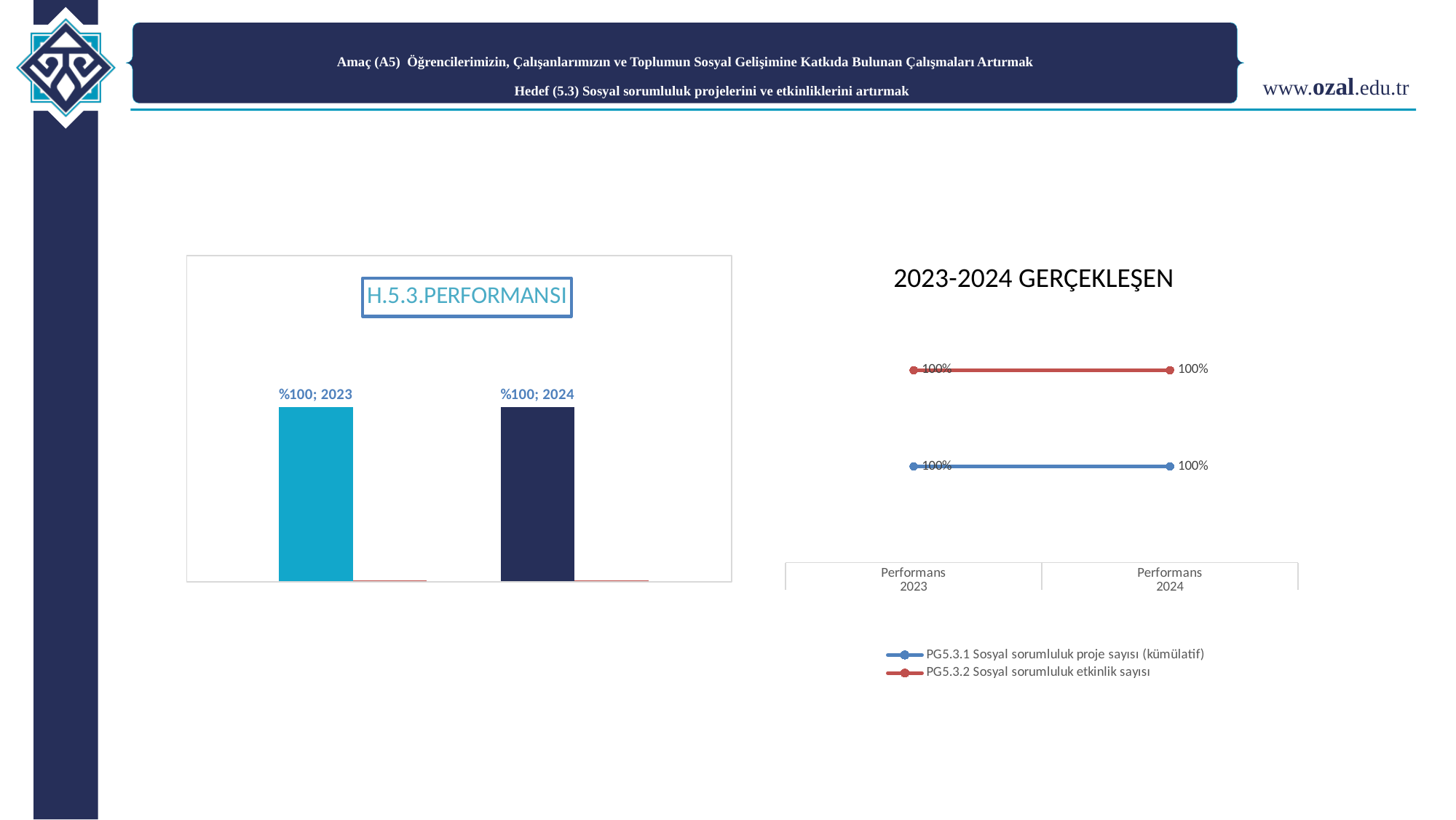
In the 2023-2024 GERÇEKLEŞEN chart, which colour is the line for PG5.3.2 Sosyal sorumluluk etkinlik sayısı? red In the H.5.3.PERFORMANSI chart, what is the value for 2024? %100 What kind of chart is the H.5.3.PERFORMANSI chart? bar chart How many series does the legend of the 2023-2024 GERÇEKLEŞEN chart list? 2 In the 2023-2024 GERÇEKLEŞEN chart, how many categories are on the x axis? 2 In the H.5.3.PERFORMANSI chart, what is the difference between the 2023 and 2024 values? 0 In the 2023-2024 GERÇEKLEŞEN chart, what is the value of PG5.3.2 Sosyal sorumluluk etkinlik sayısı for Performans 2024? 100% In the 2023-2024 GERÇEKLEŞEN chart, what is the value of PG5.3.1 Sosyal sorumluluk proje sayısı (kümülatif) for Performans 2023? 100% How many bars are shown in the H.5.3.PERFORMANSI chart? 2 In the H.5.3.PERFORMANSI chart, what is the value for 2023? %100 What kind of chart is the 2023-2024 GERÇEKLEŞEN chart? line chart In the H.5.3.PERFORMANSI chart, do the values rise, fall or stay the same from 2023 to 2024? stay the same